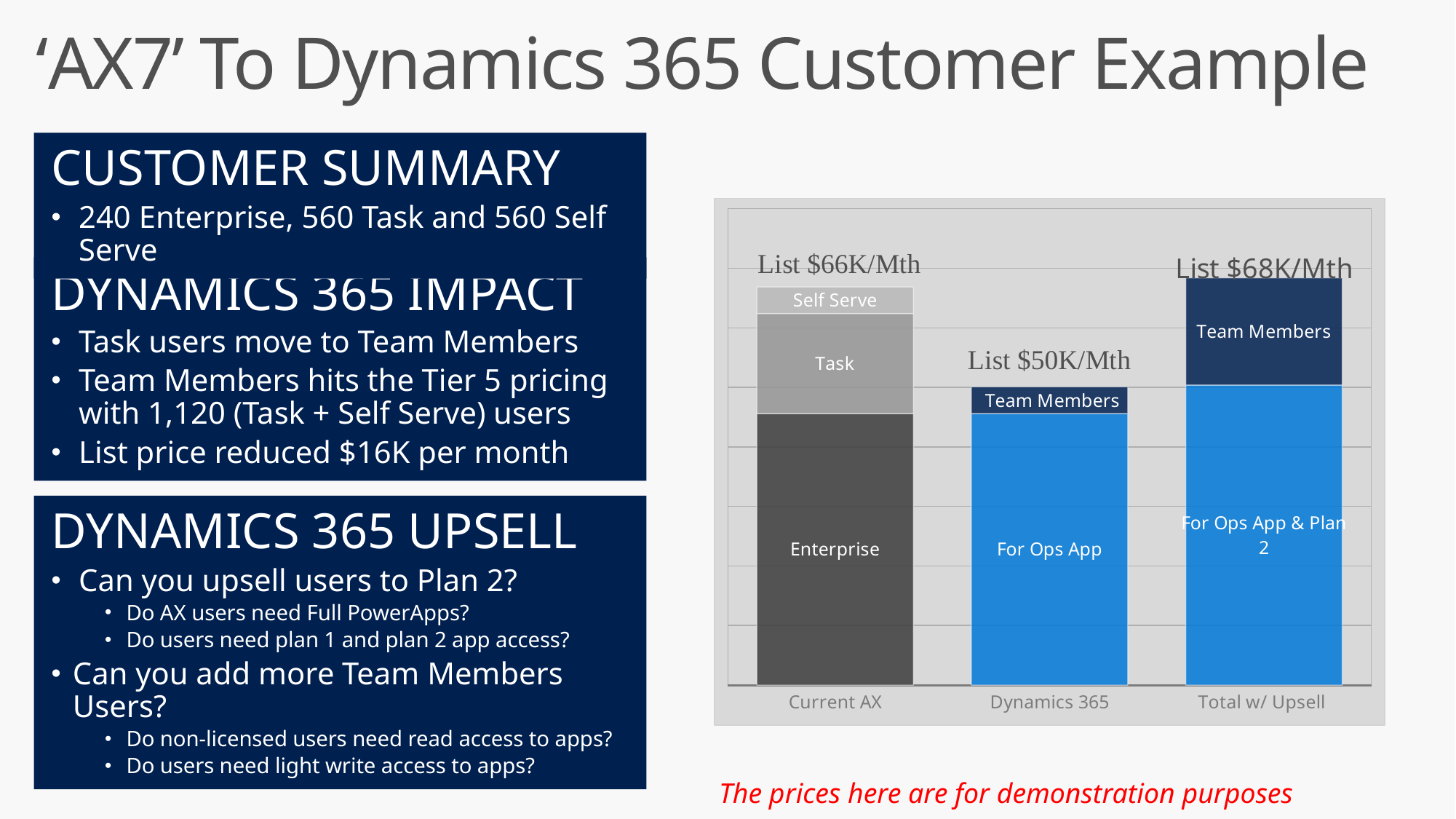
What is the difference in monthly list price between Current AX and Dynamics 365? $16K How many categories are shown on the x axis of the chart? 3 What is the list price label shown above the Total w/ Upsell bar? List $68K/Mth What type of chart is shown on the slide? Stacked bar chart How many segments make up the Current AX bar? 3 What is the list price label shown above the Current AX bar? List $66K/Mth Which has a higher monthly list price, Current AX or Dynamics 365? Current AX Which category has the lowest list price per month? Dynamics 365 What is the label of the bottom segment of the Total w/ Upsell bar? For Ops App & Plan 2 What is the difference in monthly list price between Total w/ Upsell and Current AX? $2K What is the list price label shown above the Dynamics 365 bar? List $50K/Mth Which category has the highest list price per month? Total w/ Upsell